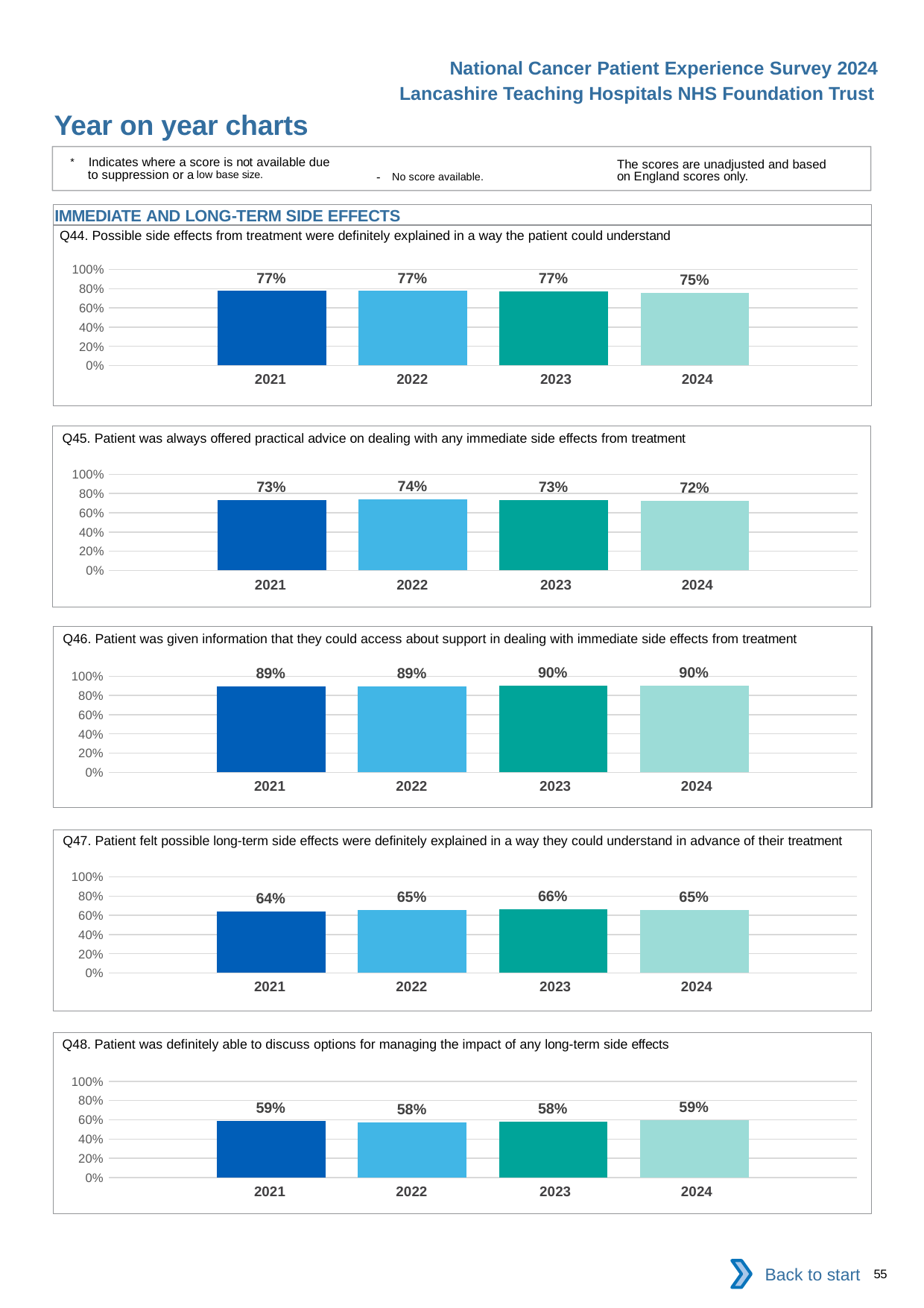
In the Q45 chart, which year has the lowest value? 2024 What is the section heading above the Q44 chart? IMMEDIATE AND LONG-TERM SIDE EFFECTS In the Q46 chart, what is the value for 2021? 89% In the Q44 chart, how many years are shown on the x axis? 4 What kind of chart is the Q46 chart? bar chart In the Q48 chart, what is the value for 2022? 58% In the Q45 chart, which year has the highest value? 2022 In the Q47 chart, what is the difference between the 2023 value and the 2021 value? 2% In the Q48 chart, is the value for 2021 greater or less than 80%? less In the Q44 chart, is the 2021 value larger or smaller than the 2024 value? larger In the Q44 chart, what is the value for 2024? 75% In the Q47 chart, which year has the lowest value? 2021